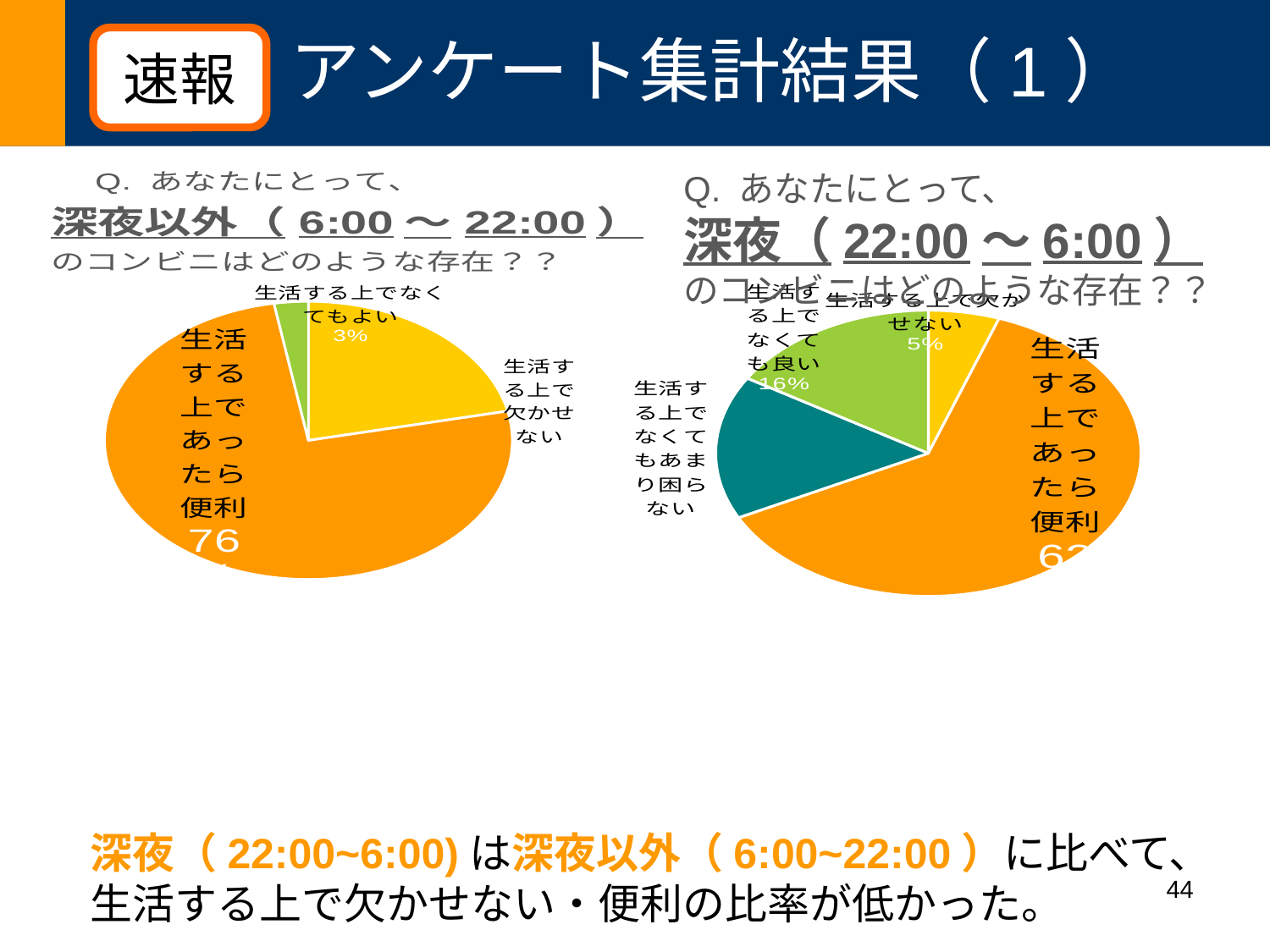
In the left chart (深夜以外 6:00〜22:00), which slice is larger: 生活する上であったら便利 or 生活する上で欠かせない? 生活する上であったら便利 In the right chart (深夜 22:00〜6:00), which category has the smallest slice? 生活する上で欠かせない How many slices does the left chart (深夜以外 6:00〜22:00) have? 3 In the right chart (深夜 22:00〜6:00), what percentage is shown for 生活する上で欠かせない? 5% In the left chart (深夜以外 6:00〜22:00), which category has the smallest slice? 生活する上でなくてもよい In the left chart (深夜以外 6:00〜22:00), what percentage is shown for 生活する上でなくてもよい? 3% In the right chart (深夜 22:00〜6:00), which category has the largest slice? 生活する上であったら便利 In the right chart (深夜 22:00〜6:00), what percentage is shown for 生活する上でなくても良い? 16% What kind of chart is the left chart (深夜以外 6:00〜22:00)? pie chart In the right chart (深夜 22:00〜6:00), what is the difference in percentage points between 生活する上でなくても良い and 生活する上で欠かせない? 11 In the left chart (深夜以外 6:00〜22:00), which category has the largest slice? 生活する上であったら便利 How many slices does the right chart (深夜 22:00〜6:00) have? 4